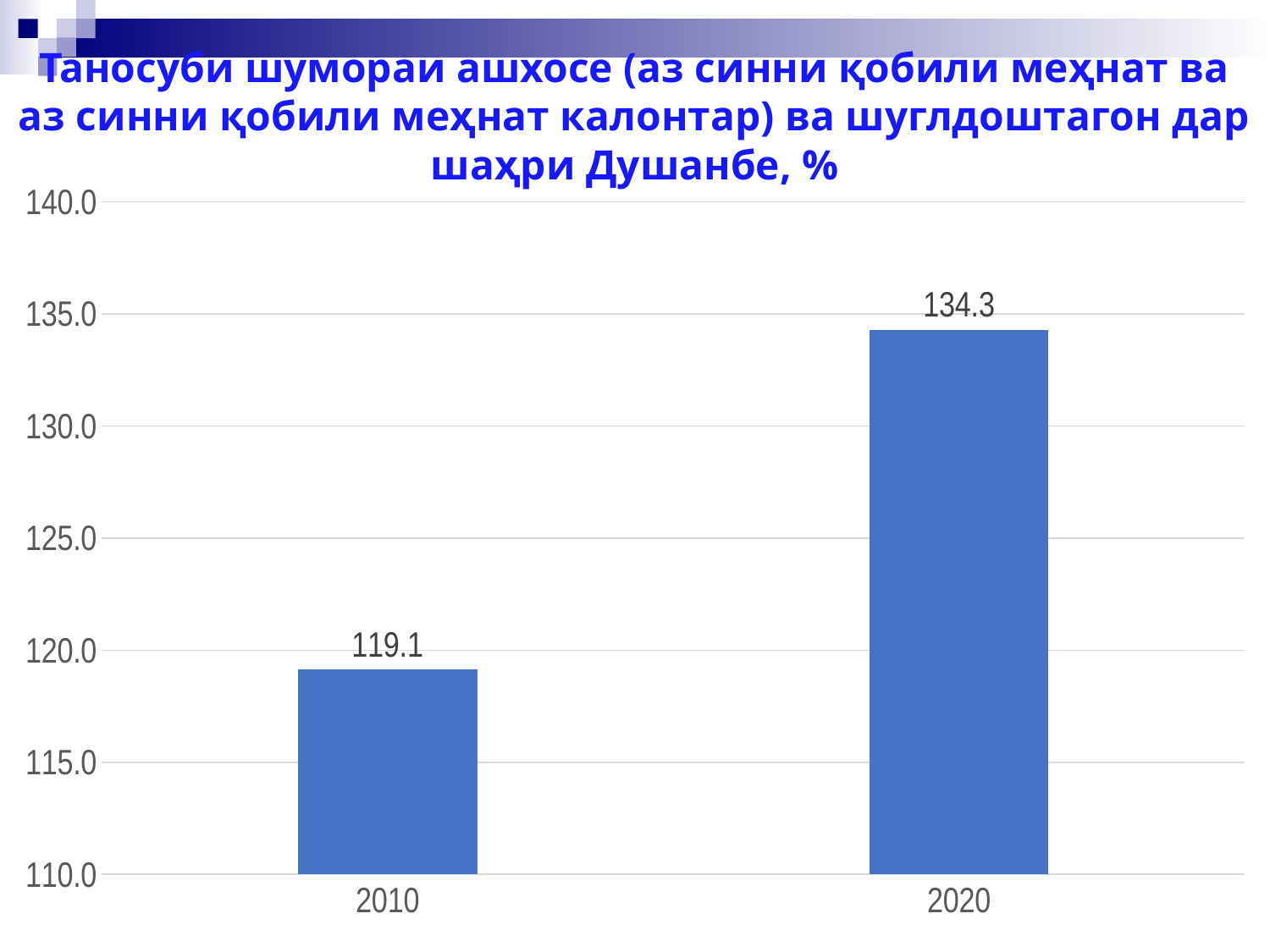
Is the value for 2010 greater or less than 120.0? less What kind of chart is shown on the slide? bar chart How many years are shown on the x axis? 2 Do the values rise or fall from 2010 to 2020? rise What is the highest tick value shown on the y axis? 140.0 Which year has the highest value? 2020 Which year has the lowest value? 2010 What is the value for 2010? 119.1 What is the difference between the values for 2020 and 2010? 15.2 What is the value for 2020? 134.3 Which is larger, the value for 2010 or the value for 2020? 2020 Is the value for 2020 greater or less than 130.0? greater